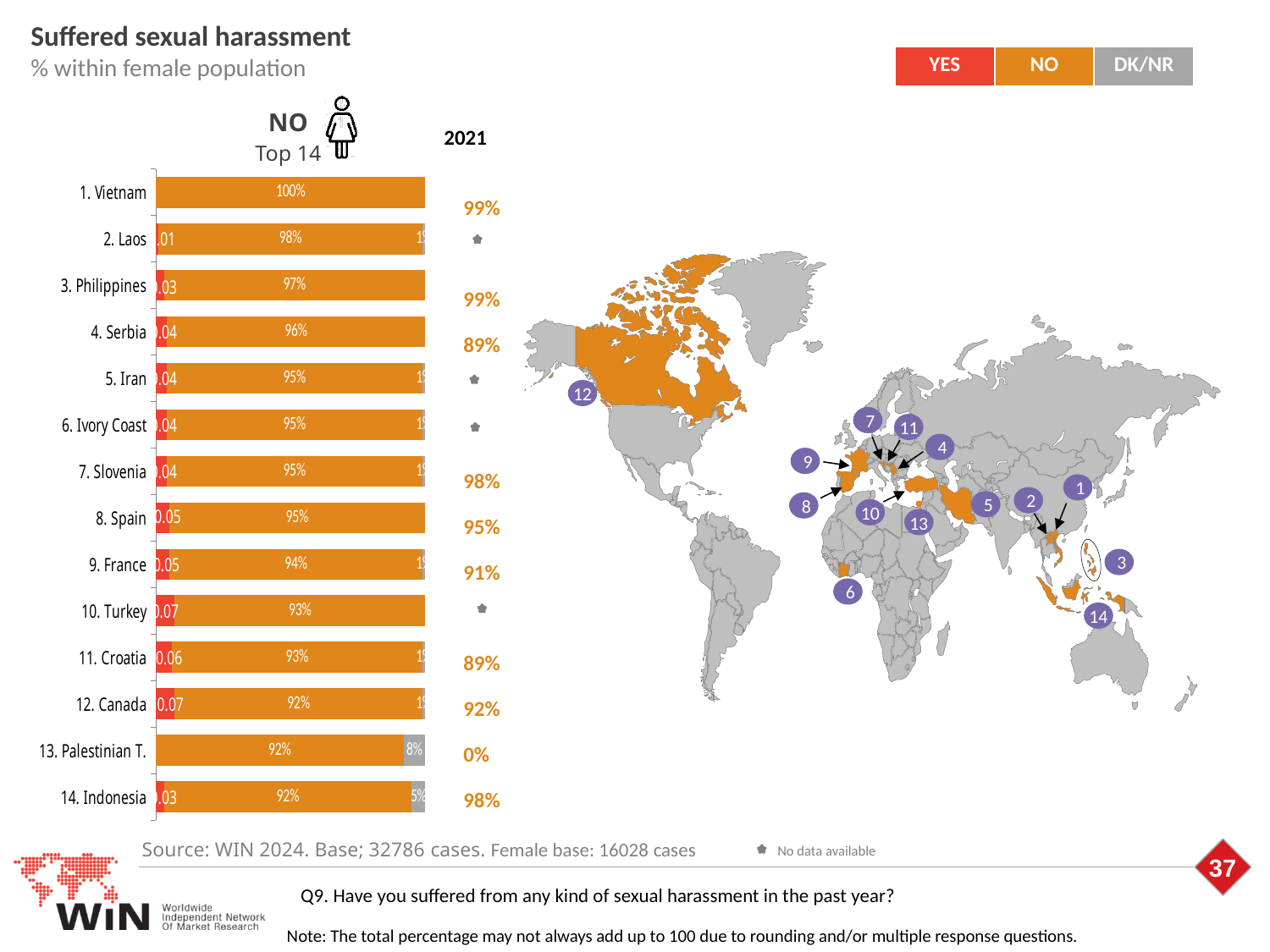
What are the three entries in the legend? YES, NO, DK/NR What is the NO percentage for Vietnam? 100% Which country has the highest NO percentage? 1. Vietnam What is the DK/NR percentage for Indonesia? 5% What is the DK/NR percentage for Palestinian T.? 8% How many countries are shown in the bar chart? 14 What is the NO percentage for Philippines? 97% What is the difference between the NO percentage for Vietnam and the NO percentage for Canada? 8% Which has a higher NO percentage, Serbia or Turkey? Serbia How many series does the legend list? 3 What kind of chart is used to show the Top 14 countries? Stacked bar chart What is the NO percentage for France? 94%